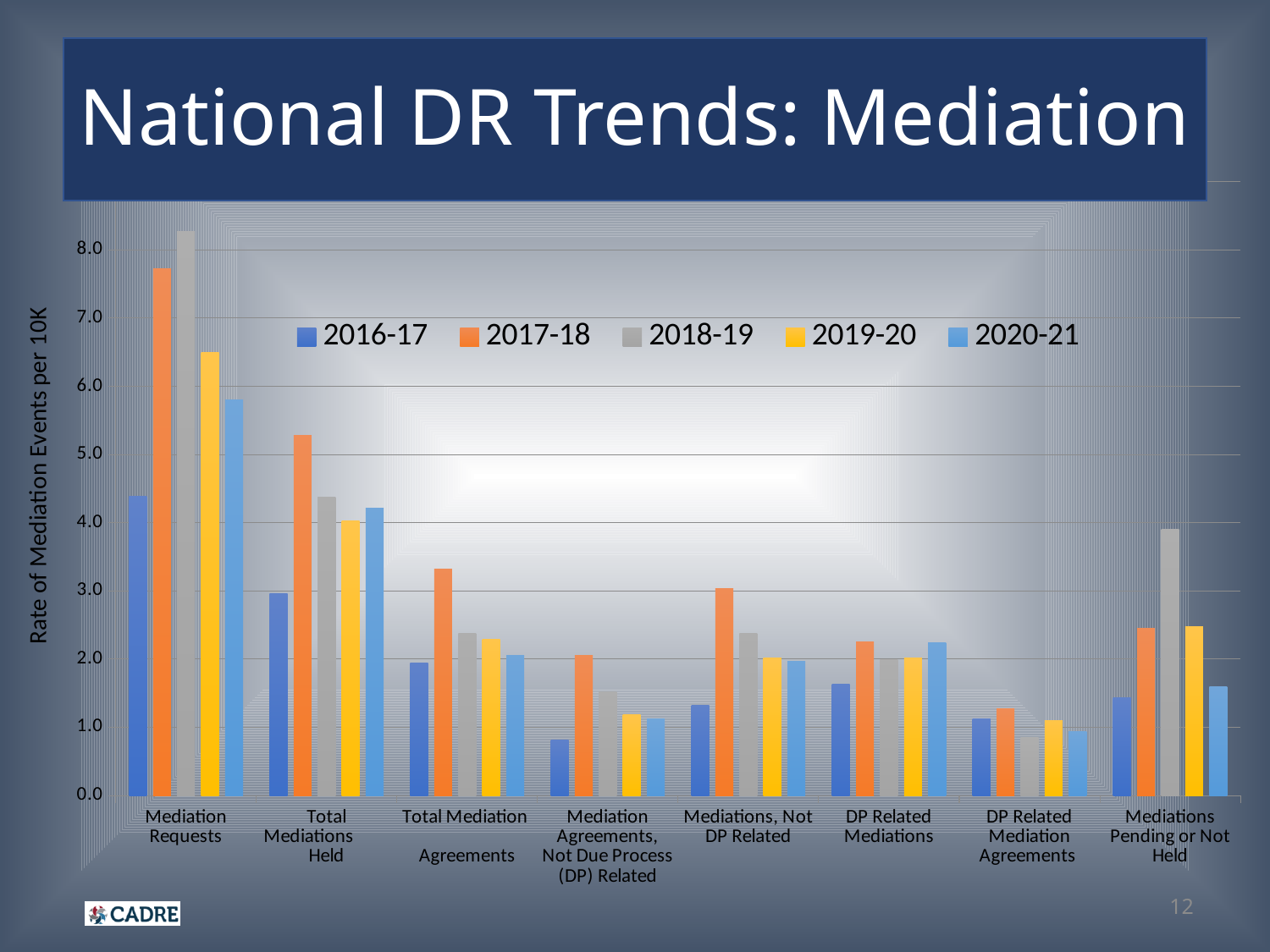
How many series does the legend list? 5 For Mediation Requests, which is larger: the 2017-18 value or the 2019-20 value? 2017-18 For Mediations Pending or Not Held, which is larger: the 2018-19 value or the 2017-18 value? 2018-19 Is the 2016-17 value for Mediation Agreements, Not Due Process (DP) Related greater or less than 1.0? less Is the 2016-17 value for Mediations, Not DP Related greater or less than 1.0? greater Which series has the lowest value for Mediation Requests? 2016-17 Which category has the highest 2018-19 bar? Mediation Requests What is the title of the y axis? Rate of Mediation Events per 10K How many categories are shown along the x axis? 8 Is the 2018-19 value for Mediation Requests greater or less than 8.0? greater What kind of chart is shown on the slide? bar chart